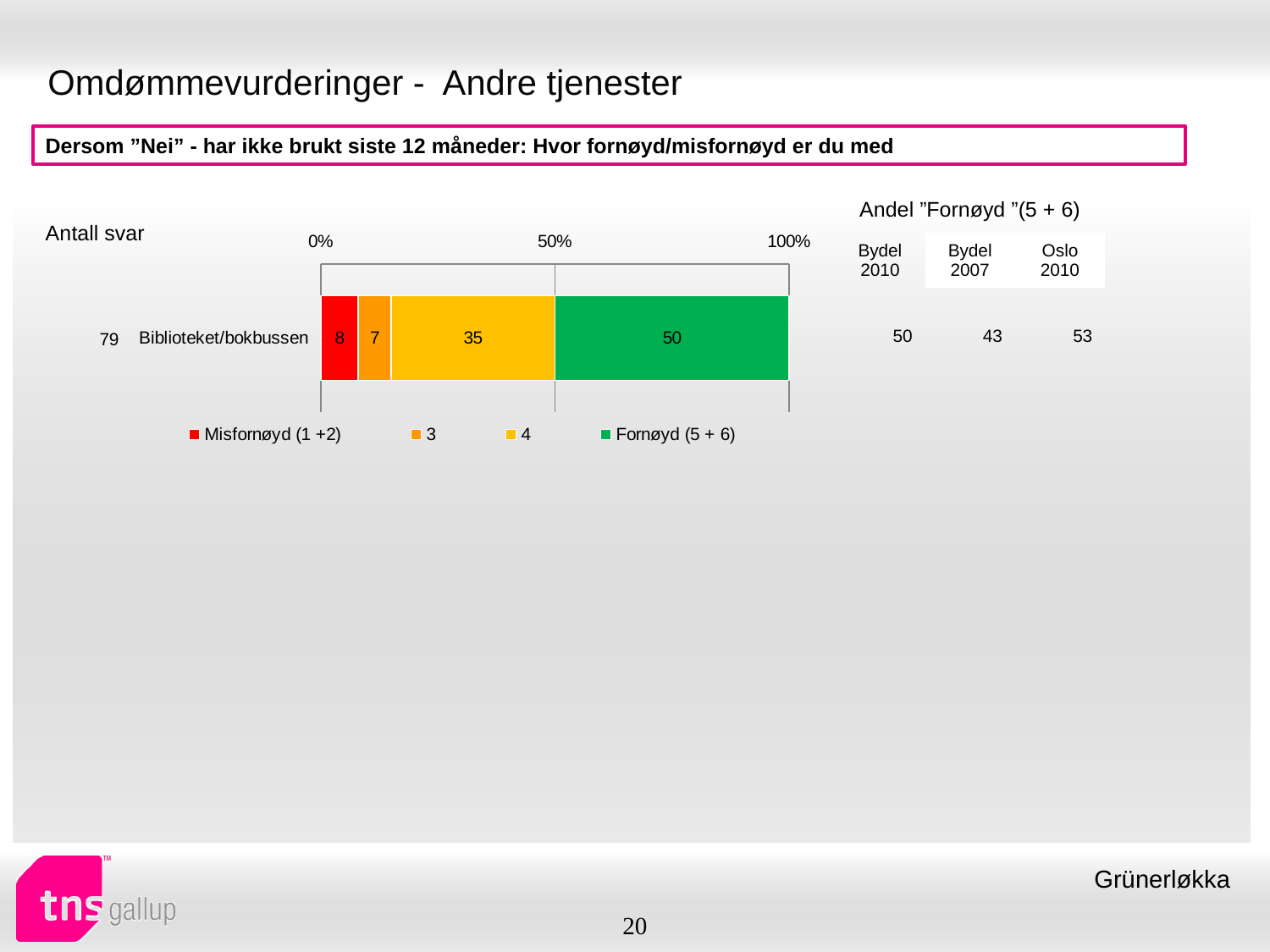
What is the value of the "4" segment for Biblioteket/bokbussen? 35 What is the value of the "3" segment for Biblioteket/bokbussen? 7 What kind of chart is shown on the slide? Stacked bar chart Which segment of the Biblioteket/bokbussen bar is the smallest? 3 What is the value of the "Fornøyd (5 + 6)" segment for Biblioteket/bokbussen? 50 What is the total of all segments in the Biblioteket/bokbussen bar? 100 How many series does the legend list? 4 What is the value of the "Misfornøyd (1 +2)" segment for Biblioteket/bokbussen? 8 Which segment of the Biblioteket/bokbussen bar is the largest? Fornøyd (5 + 6) What is the difference between the "Fornøyd (5 + 6)" segment and the "4" segment for Biblioteket/bokbussen? 15 How many categories are plotted in the chart? 1 Which is larger for Biblioteket/bokbussen, the "Misfornøyd (1 +2)" segment or the "3" segment? Misfornøyd (1 +2)